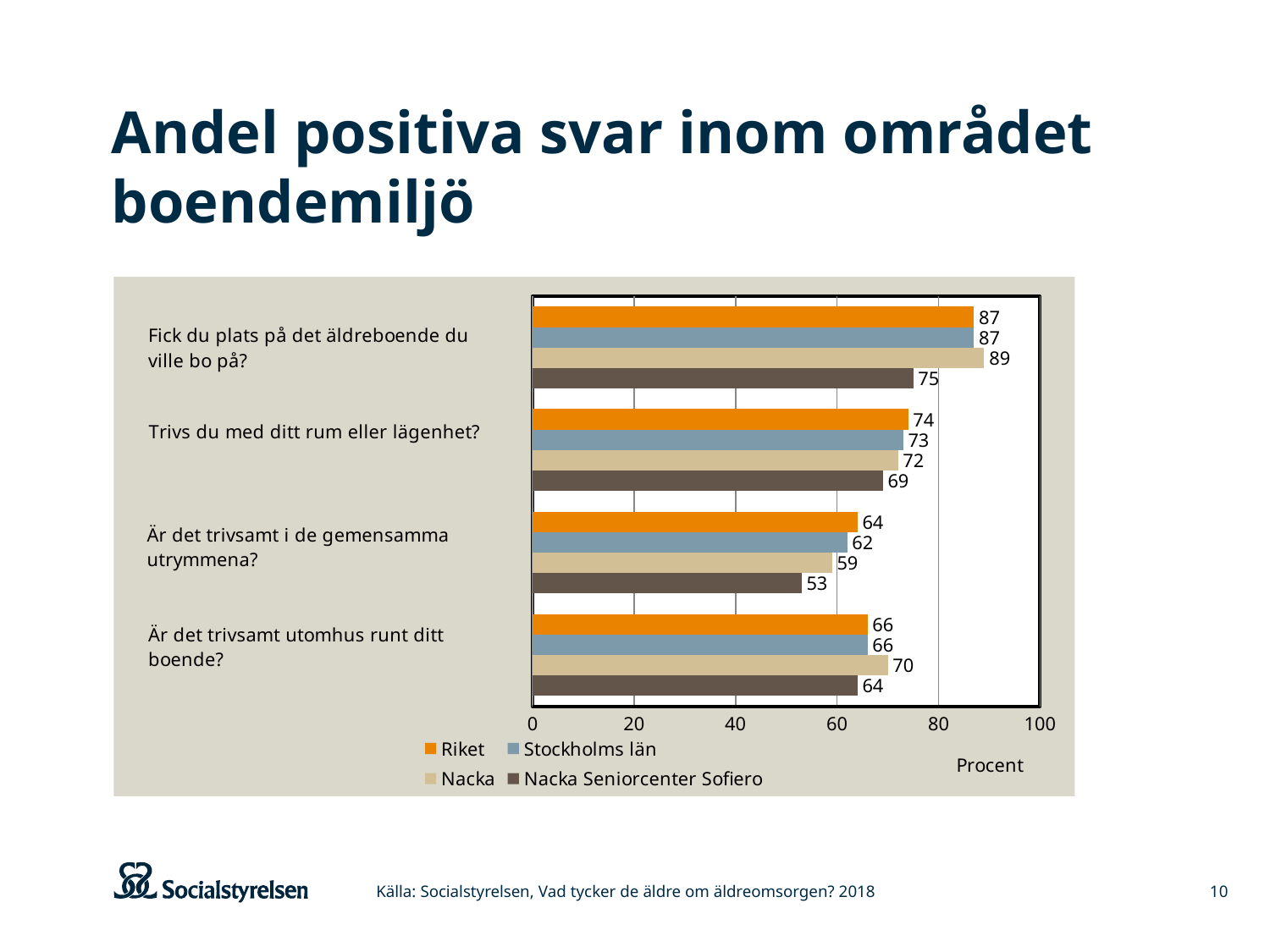
Which series has the lowest value on "Trivs du med ditt rum eller lägenhet?"? Nacka Seniorcenter Sofiero What is the difference between Nacka and Nacka Seniorcenter Sofiero on "Fick du plats på det äldreboende du ville bo på?"? 14 What is the value for Nacka on "Fick du plats på det äldreboende du ville bo på?"? 89 Which is larger on "Är det trivsamt utomhus runt ditt boende?": Nacka or Nacka Seniorcenter Sofiero? Nacka How many series does the legend list? 4 Which series has the highest value on "Fick du plats på det äldreboende du ville bo på?"? Nacka What is the value for Riket on "Är det trivsamt utomhus runt ditt boende?"? 66 How many question categories are shown on the chart? 4 What is the label on the horizontal axis of the chart? Procent What kind of chart is shown on the slide? Bar chart What is the value for Stockholms län on "Trivs du med ditt rum eller lägenhet?"? 73 What is the value for Nacka Seniorcenter Sofiero on "Är det trivsamt i de gemensamma utrymmena?"? 53